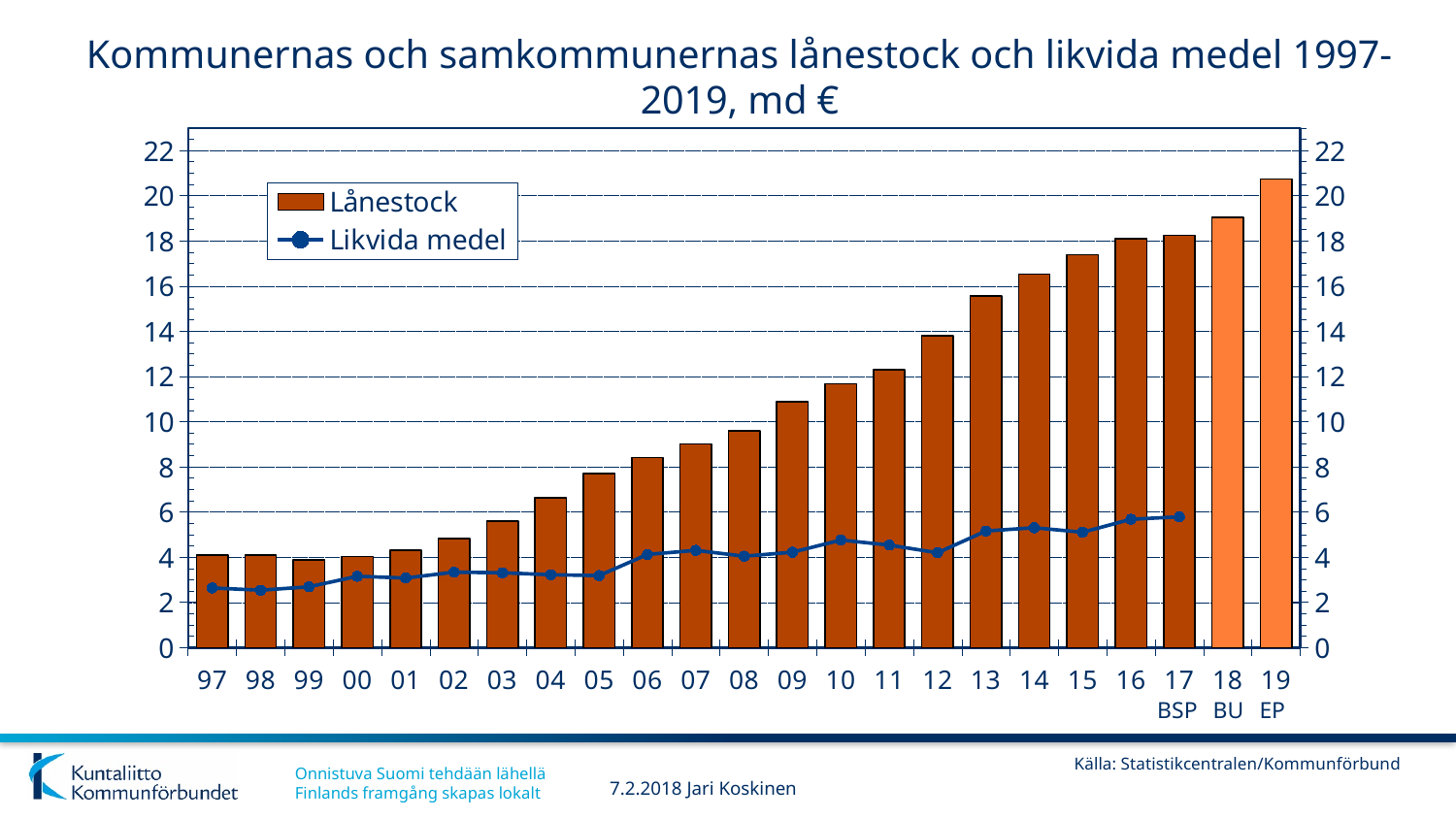
Is the Likvida medel value for 97 greater or less than 4? less Is the Lånestock value for 09 greater or less than 10? greater How many years (bars) are shown on the x axis? 23 Is the Lånestock value for 13 greater or less than 16? less Do the Lånestock values generally rise or fall from 97 to 19? rise How many series does the legend list? 2 What are the two entries listed in the legend? Lånestock and Likvida medel Which year has the highest Lånestock bar? 19 Which is larger, the Likvida medel value for 10 or for 12? 10 What kind of chart is shown on the slide? bar chart with a line Which is larger, the Lånestock value for 17 or for 18? 18